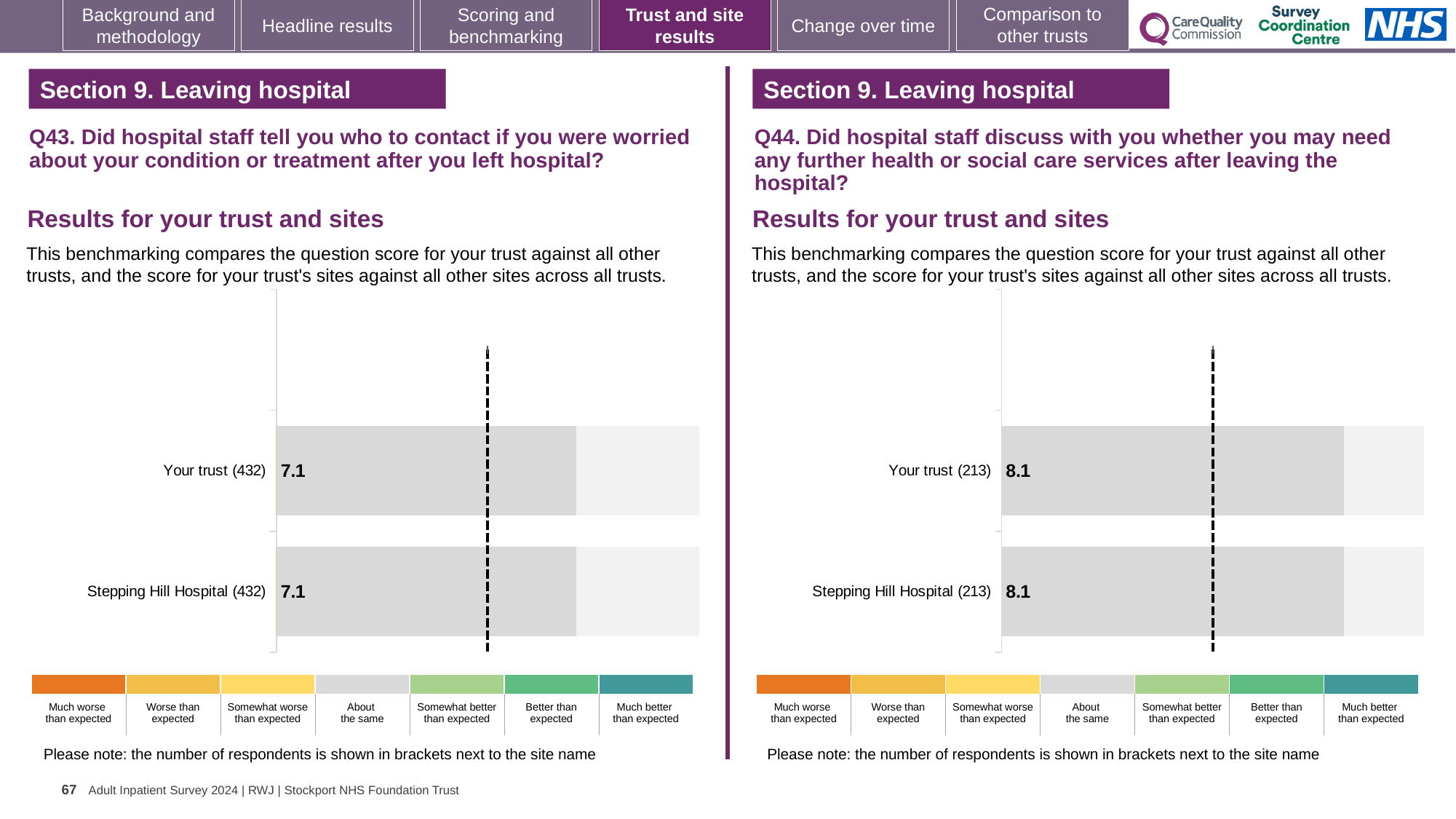
How many bars are plotted in the Q44 chart on the right? 2 In the Q43 chart on the left, what is the difference between the score for Your trust and the score for Stepping Hill Hospital? 0 In the Q43 chart on the left, what is the score for Your trust? 7.1 In the Q43 chart on the left, how many respondents are shown in brackets for Your trust? 432 In the Q44 chart on the right, how many respondents are shown in brackets for Stepping Hill Hospital? 213 In the Q44 chart on the right, what is the score for Stepping Hill Hospital? 8.1 How many bars are plotted in the Q43 chart on the left? 2 In the Q43 chart on the left, what is the score for Stepping Hill Hospital? 7.1 In the Q43 chart on the left, which benchmark category does the grey colour of the bars correspond to in the legend? About the same In the Q44 chart on the right, what is the difference between the score for Your trust and the score for Stepping Hill Hospital? 0 What kind of chart is the Q44 chart on the right? Bar chart In the Q44 chart on the right, what is the score for Your trust? 8.1